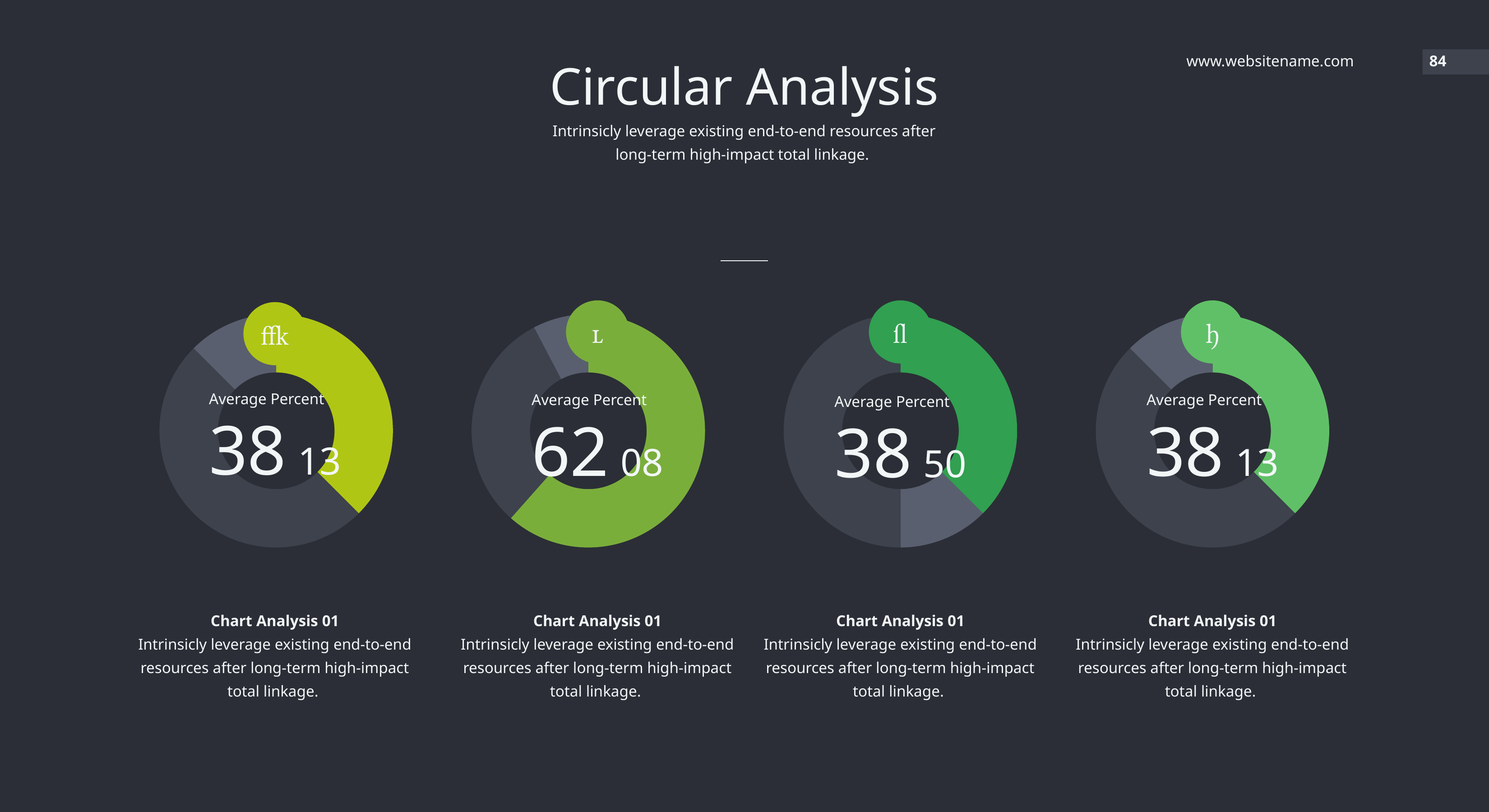
How many donut charts are shown on the slide? 4 Does the coloured arc of the second donut chart from the left cover more or less than half of the ring? More What is the title of the slide containing the four donut charts? Circular Analysis What is the large number printed in the centre of the fourth (rightmost) donut chart? 38 Which has the larger large centre number: the first donut chart or the second donut chart? The second donut chart What label appears above the number in the centre of each donut chart? Average Percent What is the large number printed in the centre of the third donut chart from the left? 38 What is the large number printed in the centre of the first (leftmost) donut chart? 38 What is the large number printed in the centre of the second donut chart from the left? 62 What kind of chart is used for each of the four 'Average Percent' figures on the slide? Donut chart Which of the four donut charts shows the highest large centre number? The second chart from the left (62) What is the difference between the large centre number of the second donut chart and that of the first donut chart? 24